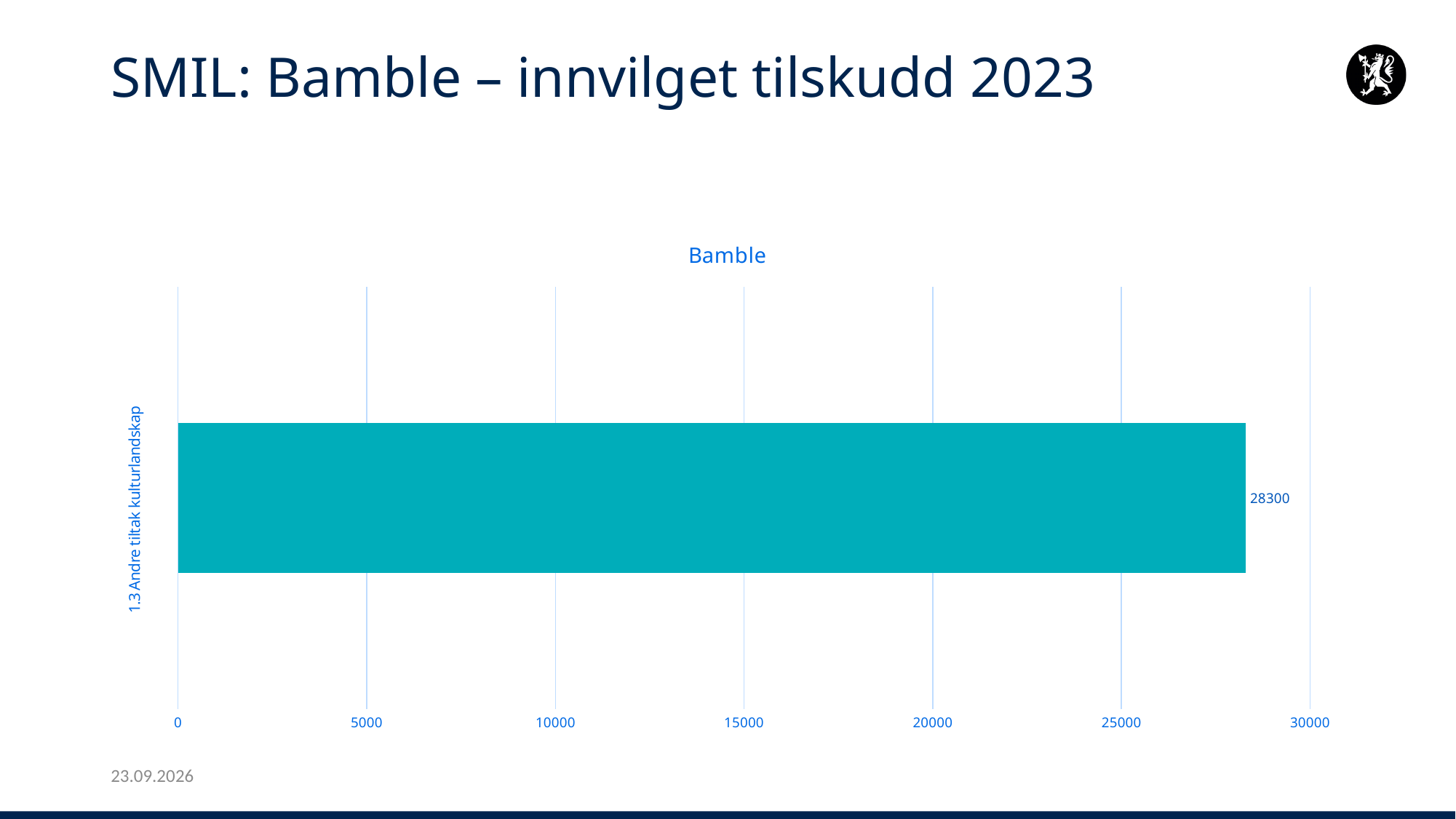
What is the highest value shown on the x axis? 30000 Which category has the highest value in the chart? 1.3 Andre tiltak kulturlandskap What is the value for 1.3 Andre tiltak kulturlandskap? 28300 Is the value for 1.3 Andre tiltak kulturlandskap greater or less than 30000? less Is the value for 1.3 Andre tiltak kulturlandskap greater or less than 25000? greater What kind of chart is shown on the slide? bar chart How many categories are plotted in the chart? 1 What is the title of the chart? Bamble